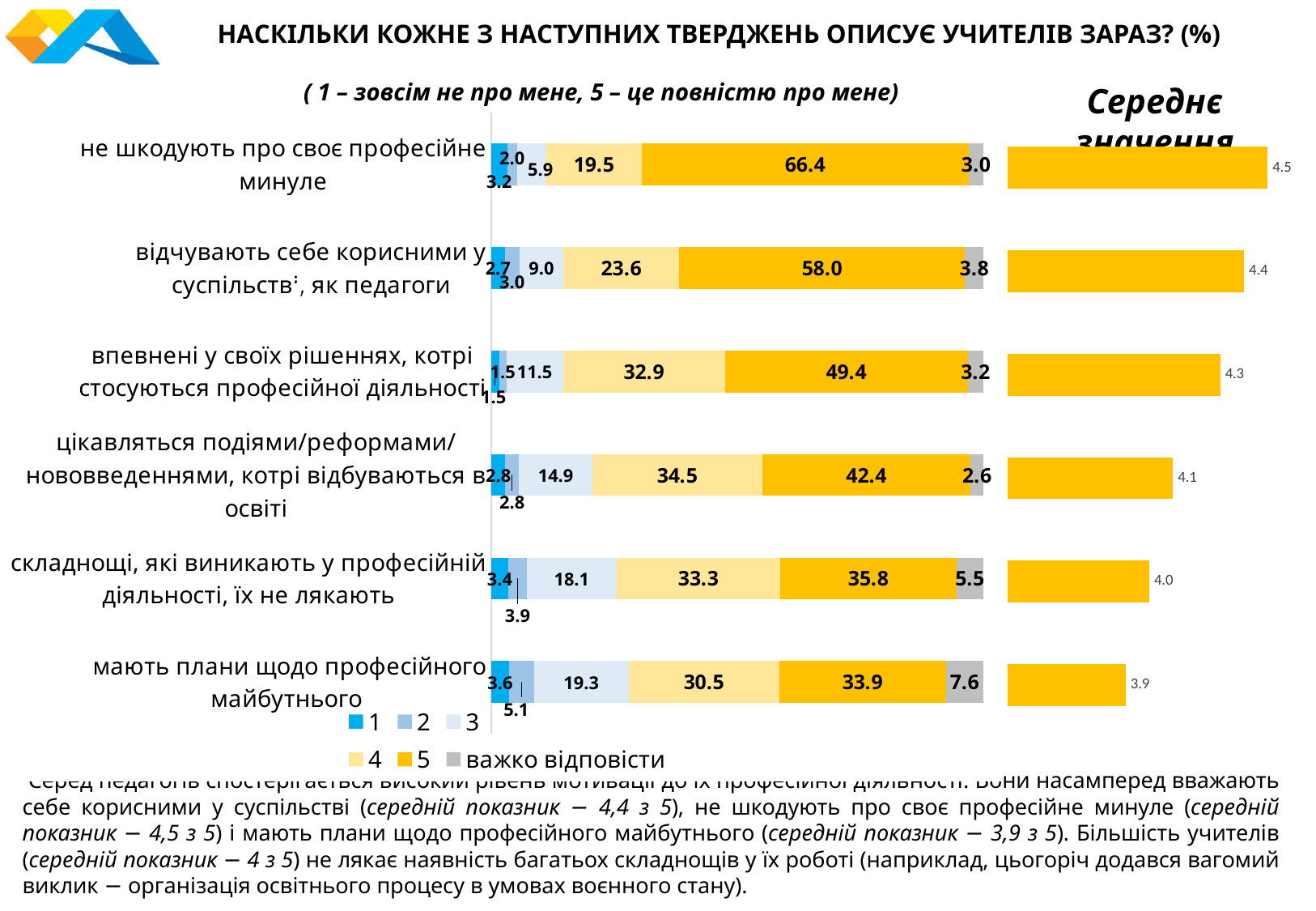
In the stacked bar chart, which is larger: the rating-4 share for "цікавляться подіями/реформами/нововведеннями, котрі відбуваються в освіті" or the rating-4 share for "складнощі, які виникають у професійній діяльності, їх не лякають"? цікавляться подіями/реформами/нововведеннями, котрі відбуваються в освіті In the stacked bar chart, what is the difference between the rating-5 share for "не шкодують про своє професійне минуле" (66.4) and for "відчувають себе корисними у суспільстві, як педагоги" (58.0)? 8.4 In the stacked bar chart, what percentage of teachers gave a rating of 5 for the statement "не шкодують про своє професійне минуле"? 66.4 How many statements (categories) are shown in the stacked bar chart? 6 How many series does the legend of the stacked bar chart list? 6 In the "Середнє значення" chart, which statement has the highest mean value? не шкодують про своє професійне минуле In the "Середнє значення" chart, what is the mean value for the statement "відчувають себе корисними у суспільстві, як педагоги"? 4.4 In the stacked bar chart, what percentage answered "важко відповісти" for the statement "мають плани щодо професійного майбутнього"? 7.6 In the stacked bar chart, which statement has the largest share of rating 5? не шкодують про своє професійне минуле In the stacked bar chart, what percentage gave a rating of 4 for the statement "впевнені у своїх рішеннях, котрі стосуються професійної діяльності"? 32.9 What type of chart is used to show the distribution of ratings for each statement? Stacked bar chart In the "Середнє значення" chart, which statement has the lowest mean value? мають плани щодо професійного майбутнього